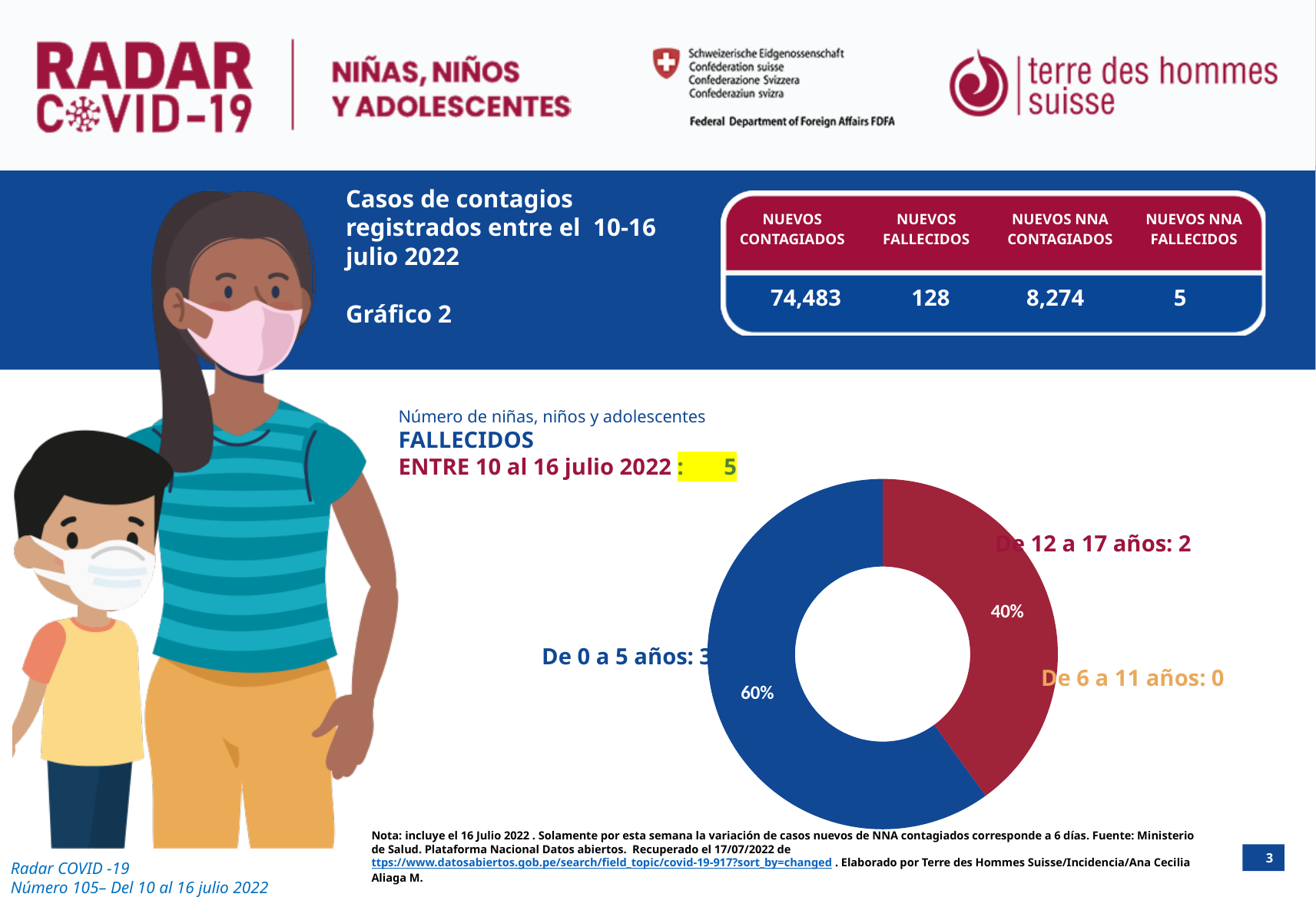
How many deaths are shown for the 'De 6 a 11 años' group? 0 Which group has more deaths, 'De 0 a 5 años' or 'De 12 a 17 años'? De 0 a 5 años What percentage of the donut chart corresponds to 'De 12 a 17 años'? 40% What kind of chart is shown on the slide? Donut (pie) chart What is the total number of children and adolescents who died between 10 and 16 July 2022 according to the chart? 5 Which age group has the lowest number of deaths in the chart? De 6 a 11 años How many deaths are shown for the 'De 0 a 5 años' group? 3 Which age group has the highest number of deaths in the chart? De 0 a 5 años How many age groups are labelled on the chart? 3 What is the difference in deaths between 'De 0 a 5 años' and 'De 12 a 17 años'? 1 How many deaths are shown for the 'De 12 a 17 años' group? 2 What percentage of the donut chart corresponds to 'De 0 a 5 años'? 60%